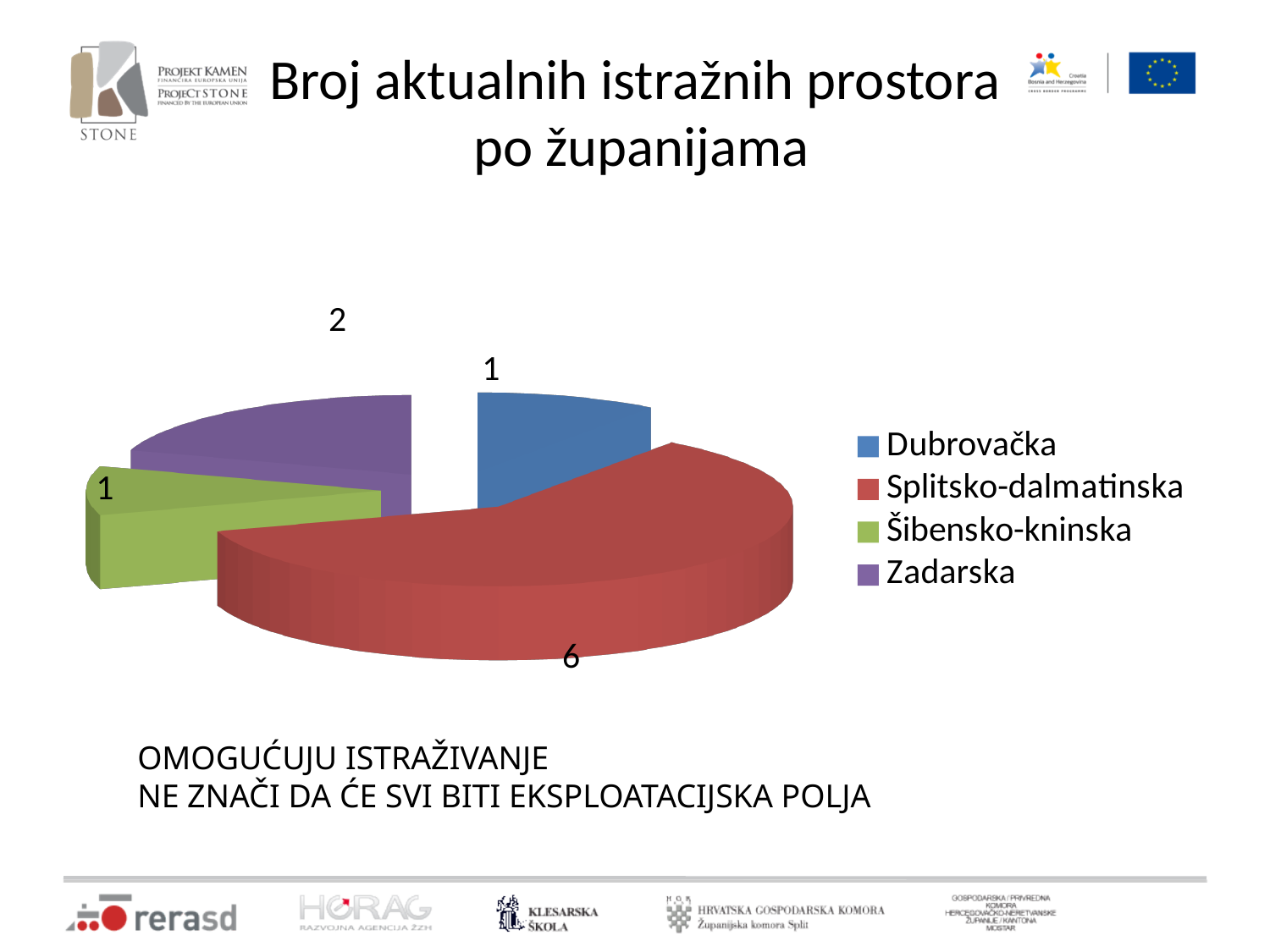
What is the value for Dubrovačka? 1 How many counties (slices) are shown in the pie chart? 4 What share of the total does Splitsko-dalmatinska represent? 60% What is the difference between the values for Splitsko-dalmatinska and Zadarska? 4 Which is larger, the value for Zadarska or the value for Dubrovačka? Zadarska What is the value for Zadarska? 2 What is the value for Šibensko-kninska? 1 What kind of chart is shown on the slide? pie chart What is the value for Splitsko-dalmatinska? 6 What share of the total does Zadarska represent? 20% What colour is the slice for Šibensko-kninska? green Which county has the largest slice of the pie? Splitsko-dalmatinska